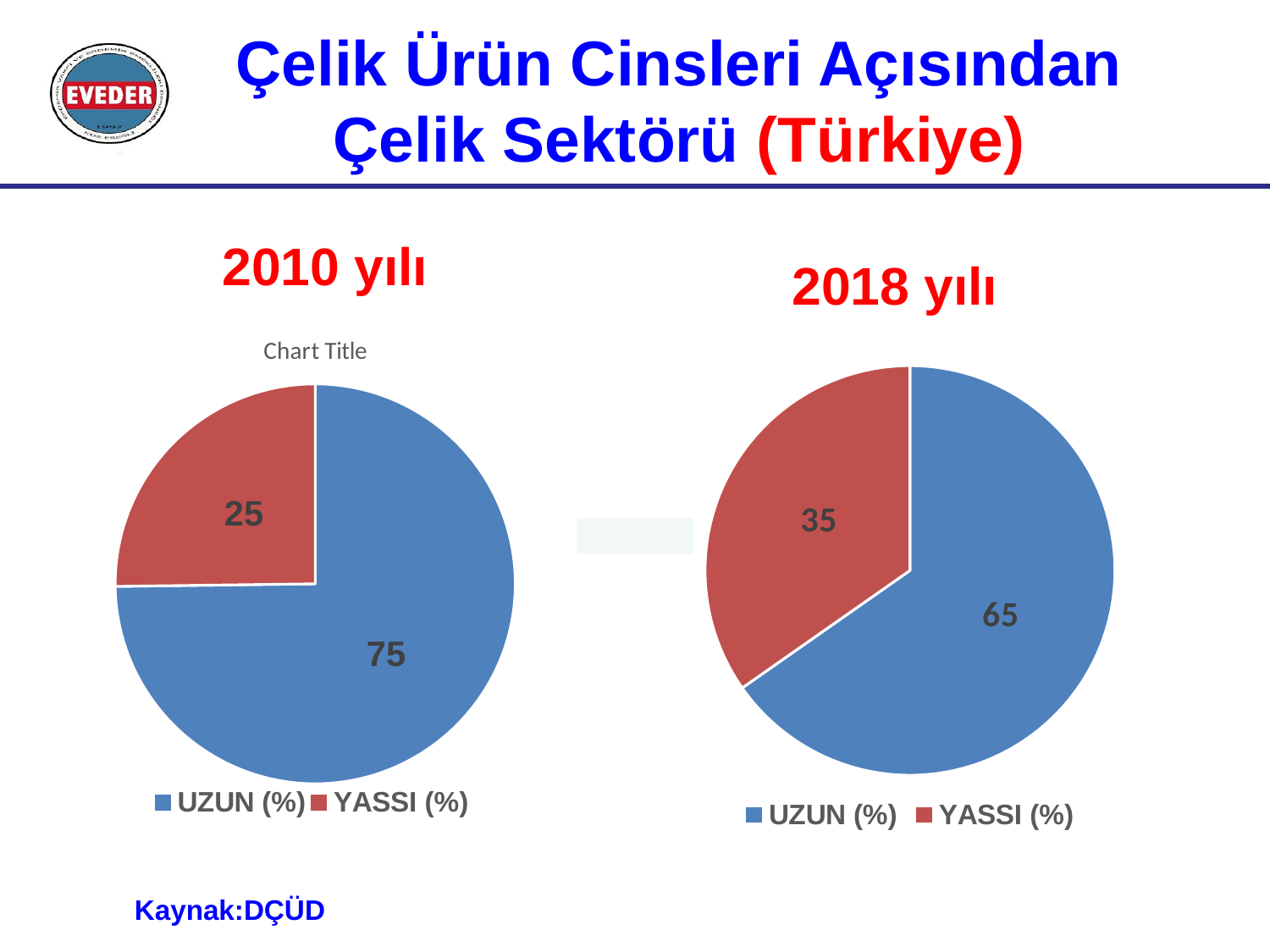
In the 2010 yılı pie chart, what is the value for YASSI (%)? 25 In the 2010 yılı pie chart, what is the value for UZUN (%)? 75 In the 2018 yılı pie chart, which category has the largest slice? UZUN (%) In the 2018 yılı pie chart, what is the difference between the UZUN (%) and YASSI (%) values? 30 In the 2018 yılı pie chart, what is the value for YASSI (%)? 35 In the 2010 yılı pie chart, what is the difference between the UZUN (%) and YASSI (%) values? 50 In the 2018 yılı pie chart, what is the value for UZUN (%)? 65 What type of chart is used for the 2018 yılı data? Pie chart Is the YASSI (%) value larger in the 2010 yılı chart or the 2018 yılı chart? 2018 yılı In the 2010 yılı pie chart, what colour is the UZUN (%) slice? Blue In the 2010 yılı pie chart, which category has the smallest slice? YASSI (%) How many categories does the legend of the 2010 yılı chart list? 2